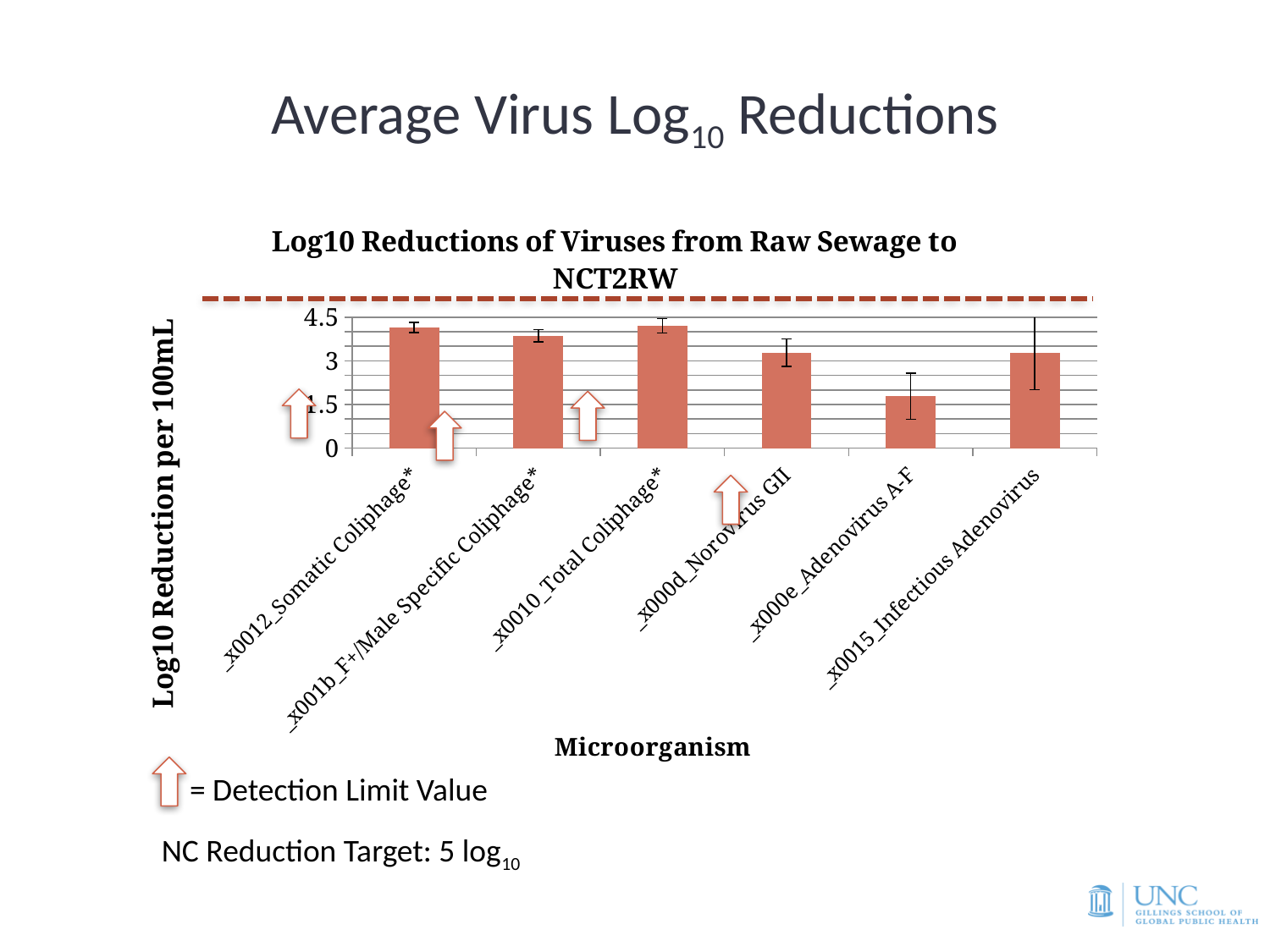
Which has a larger log10 reduction, _x001b_F+/Male Specific Coliphage* or _x000d_Norovirus GII? _x001b_F+/Male Specific Coliphage* Which has a larger log10 reduction, _x0012_Somatic Coliphage* or _x000e_Adenovirus A-F? _x0012_Somatic Coliphage* What is the title of the chart? Log10 Reductions of Viruses from Raw Sewage to NCT2RW Is the value for _x000e_Adenovirus A-F greater or less than 3? less Is the value for _x0010_Total Coliphage* greater or less than 3? greater Which microorganism has the lowest log10 reduction in the chart? _x000e_Adenovirus A-F Is the value for _x0012_Somatic Coliphage* greater or less than 3? greater What is the label of the chart's vertical axis? Log10 Reduction per 100mL What kind of chart is shown on the slide? bar chart How many microorganism categories are plotted in the chart? 6